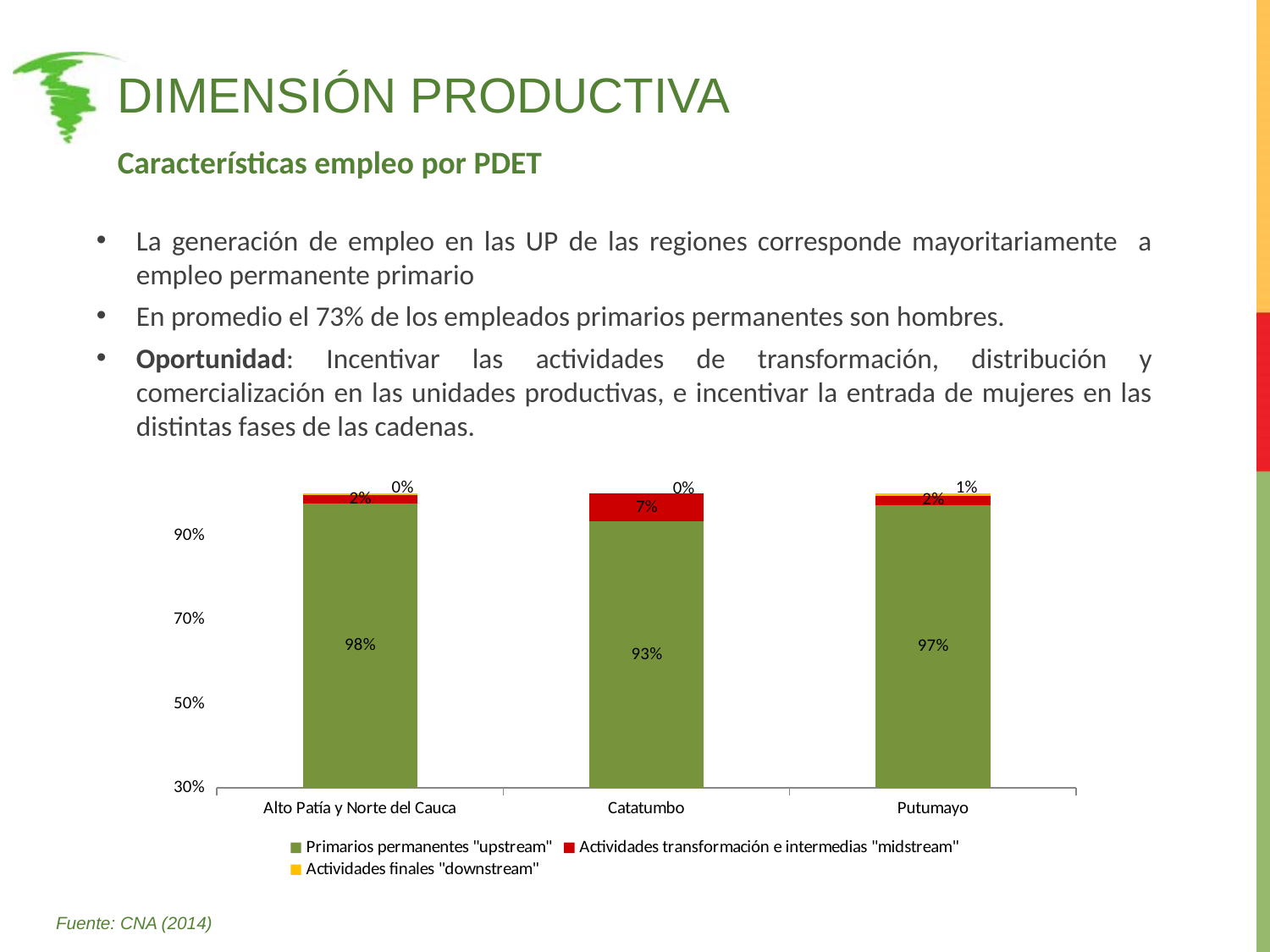
What is the value of Actividades transformación e intermedias "midstream" for Catatumbo? 7% Which colour represents Actividades finales "downstream" in the chart? Yellow What kind of chart is shown on the slide? Stacked bar chart Which region has the lowest value for Primarios permanentes "upstream"? Catatumbo What is the value of Primarios permanentes "upstream" for Catatumbo? 93% Which region has the highest value for Primarios permanentes "upstream"? Alto Patía y Norte del Cauca How many regions (categories) are shown on the x axis of the chart? 3 What is the value of Actividades finales "downstream" for Putumayo? 1% What is the difference between the Primarios permanentes "upstream" values for Alto Patía y Norte del Cauca and Catatumbo? 5% What is the value of Primarios permanentes "upstream" for Alto Patía y Norte del Cauca? 98% How many series does the chart legend list? 3 Which is larger: the "midstream" value for Catatumbo or for Putumayo? Catatumbo